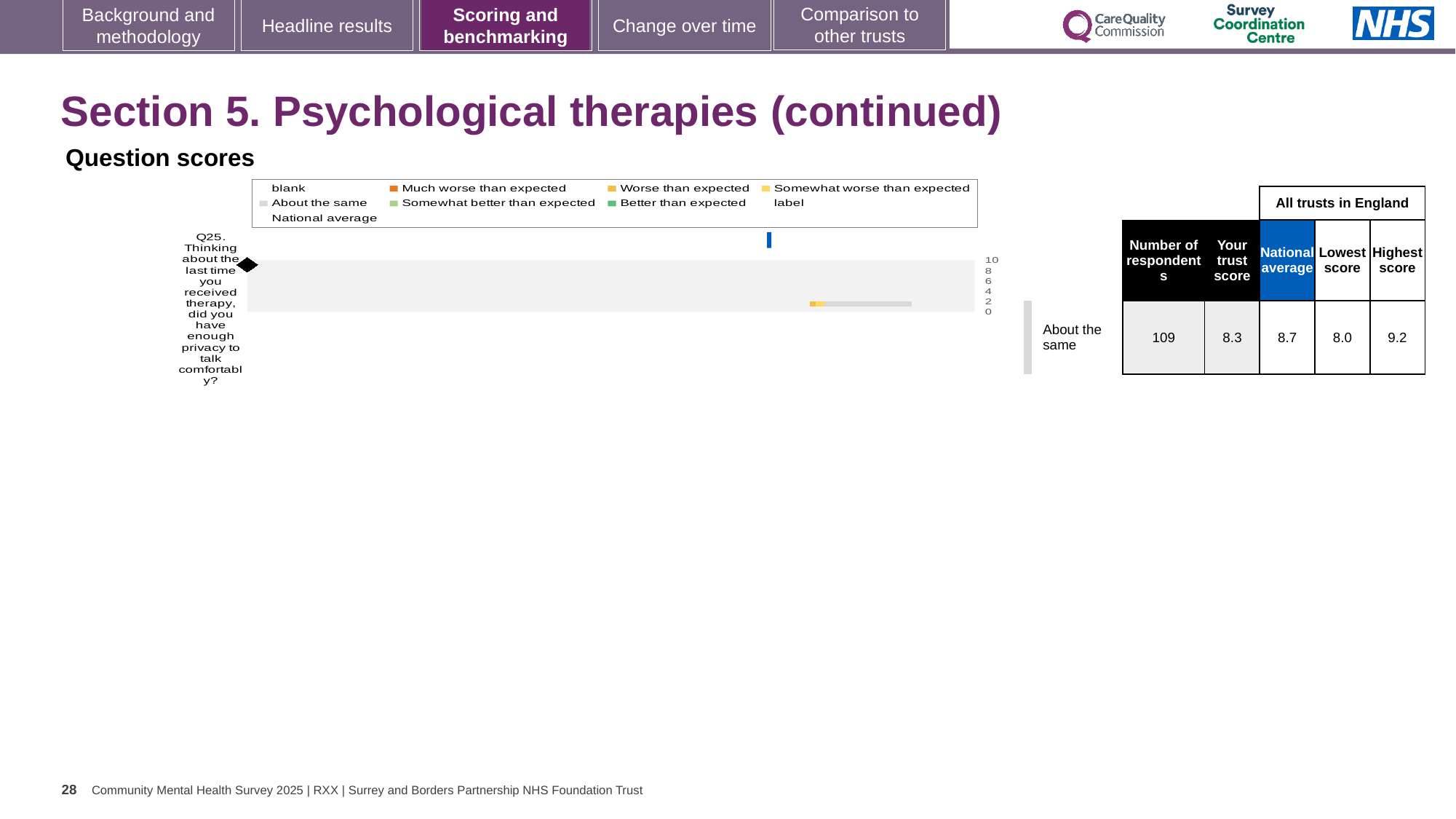
What is the lowest score across all trusts in England for Q25? 8.0 What is the trust score for Q25 shown in the table beside the chart? 8.3 What is the highest value shown on the axis of the Question scores chart? 10 What is the highest score across all trusts in England for Q25? 9.2 Which is larger for Q25, the trust score or the national average? national average What kind of chart is shown under 'Question scores'? bar chart How many questions are plotted on the Question scores chart? 1 How many respondents answered Q25? 109 Which question number is plotted on the Question scores chart? Q25 What is the national average for Q25 shown in the table beside the chart? 8.7 What is the benchmark category shown for Q25 next to the chart? About the same What is the difference between the highest score and the lowest score for Q25? 1.2